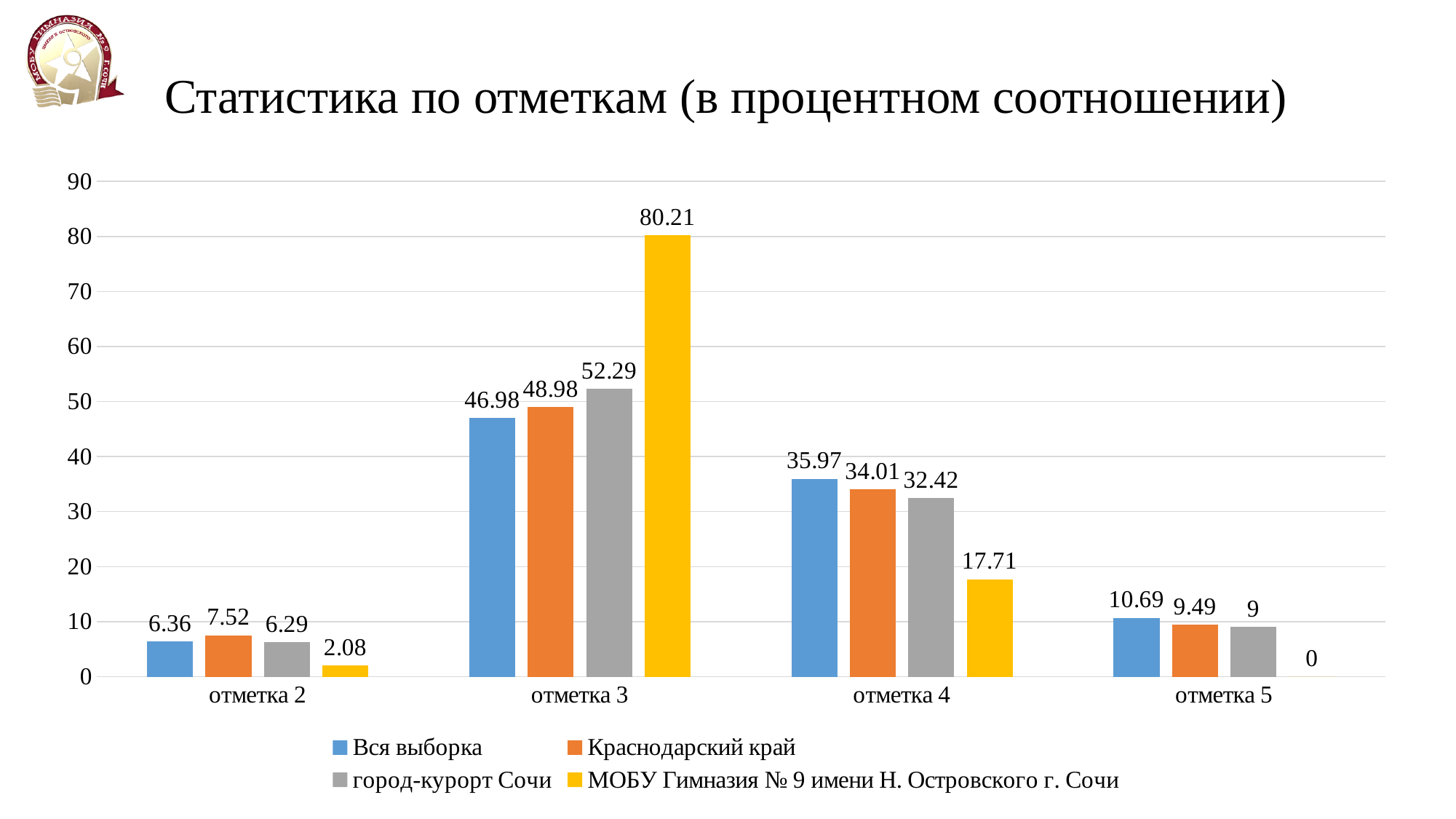
What is the value for Краснодарский край at отметка 2? 7.52 At отметка 4, which is larger: Краснодарский край or город-курорт Сочи? Краснодарский край What is the title of the chart? Статистика по отметкам (в процентном соотношении) How many categories are shown on the x axis? 4 How many series does the legend list? 4 What kind of chart is shown on the slide? bar chart What is the value for МОБУ Гимназия № 9 имени Н. Островского г. Сочи at отметка 3? 80.21 What is the value for город-курорт Сочи at отметка 5? 9 Which category has the lowest value for the Вся выборка series? отметка 2 Which category has the highest value for the МОБУ Гимназия № 9 series? отметка 3 What is the difference between the МОБУ Гимназия № 9 value and the Вся выборка value at отметка 3? 33.23 What is the value for Вся выборка at отметка 4? 35.97